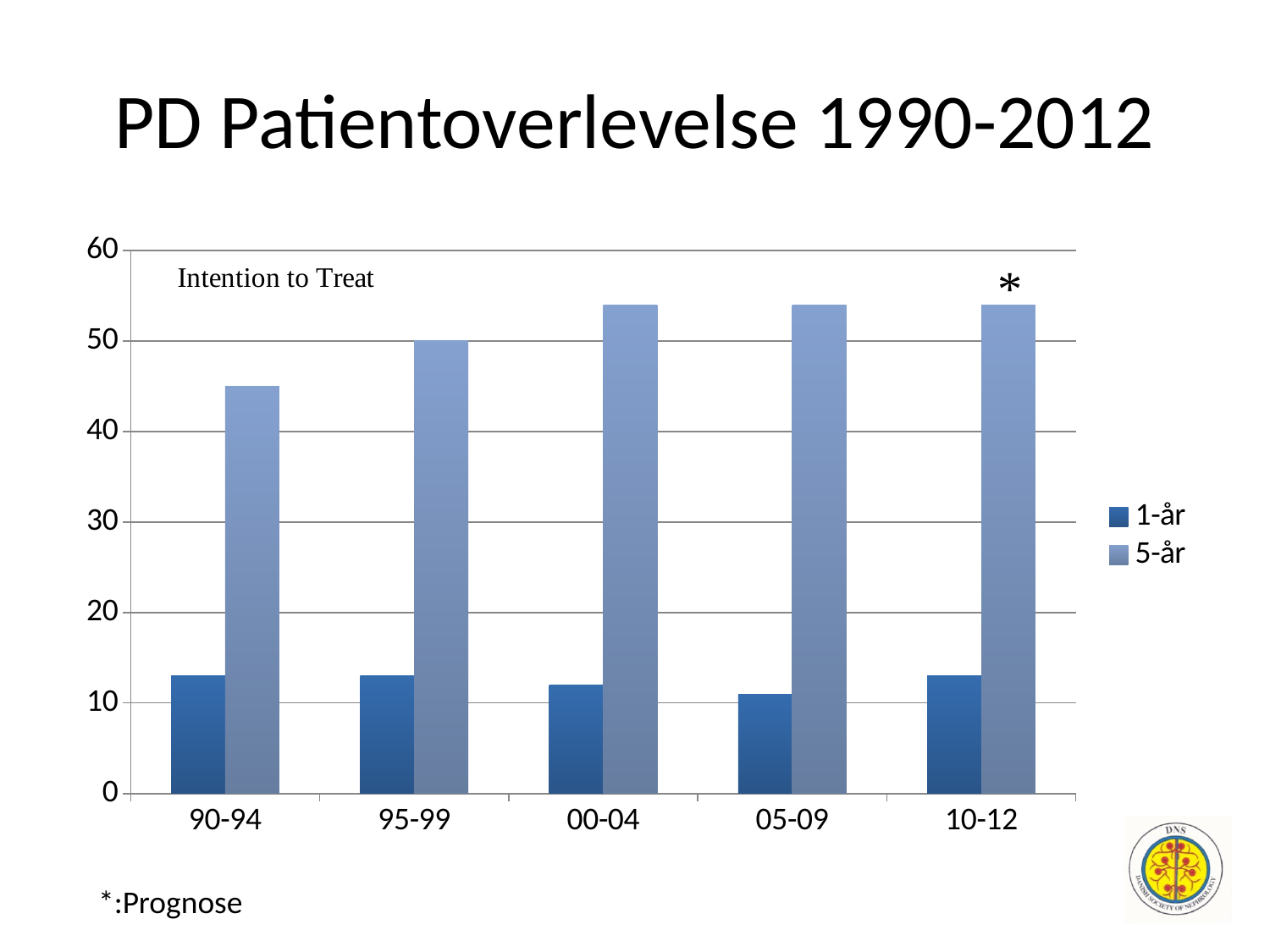
What type of chart is shown on the slide? bar chart Which is larger, the 1-år value for 90-94 or for 05-09? 90-94 Which period has the lowest 5-år value? 90-94 What does the asterisk above the 10-12 bar indicate, according to the footnote? Prognose Do the 5-år values rise or fall from 90-94 to 10-12? rise Is the 5-år value for 90-94 greater or less than 40? greater How many period categories are shown on the x axis? 5 Is the 1-år value for 90-94 greater or less than 20? less How many series does the legend list? 2 What is the 5-år value for the 95-99 period? 50 Is the 5-år value for 00-04 greater or less than 50? greater Which is larger, the 5-år value for 90-94 or for 95-99? 95-99